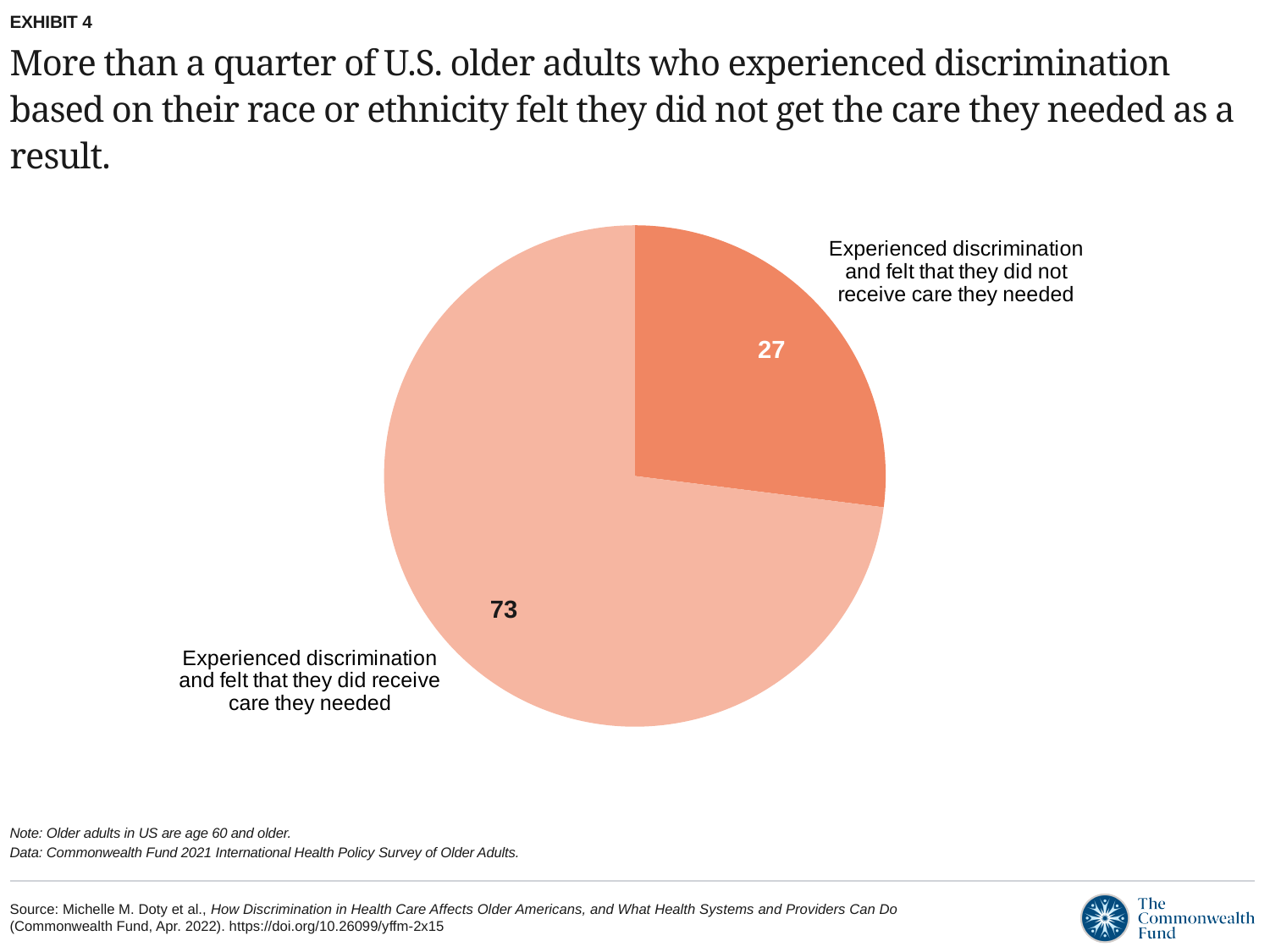
How many slices does the pie chart have? 2 What is the total of the two slice values? 100 Which is larger: the slice for those who felt they did receive care they needed, or the slice for those who felt they did not? Experienced discrimination and felt that they did receive care they needed What is the value for the slice labelled 'Experienced discrimination and felt that they did receive care they needed'? 73 What kind of chart is shown on the slide? pie chart What is the difference between the two slice values? 46 What share of the pie is taken by the slice for those who felt they did not receive care they needed? 27% Which slice of the pie is the largest? Experienced discrimination and felt that they did receive care they needed Which slice of the pie is the smallest? Experienced discrimination and felt that they did not receive care they needed What exhibit number is shown at the top of the slide? EXHIBIT 4 Which slice is drawn in the darker orange colour? Experienced discrimination and felt that they did not receive care they needed What is the value for the slice labelled 'Experienced discrimination and felt that they did not receive care they needed'? 27